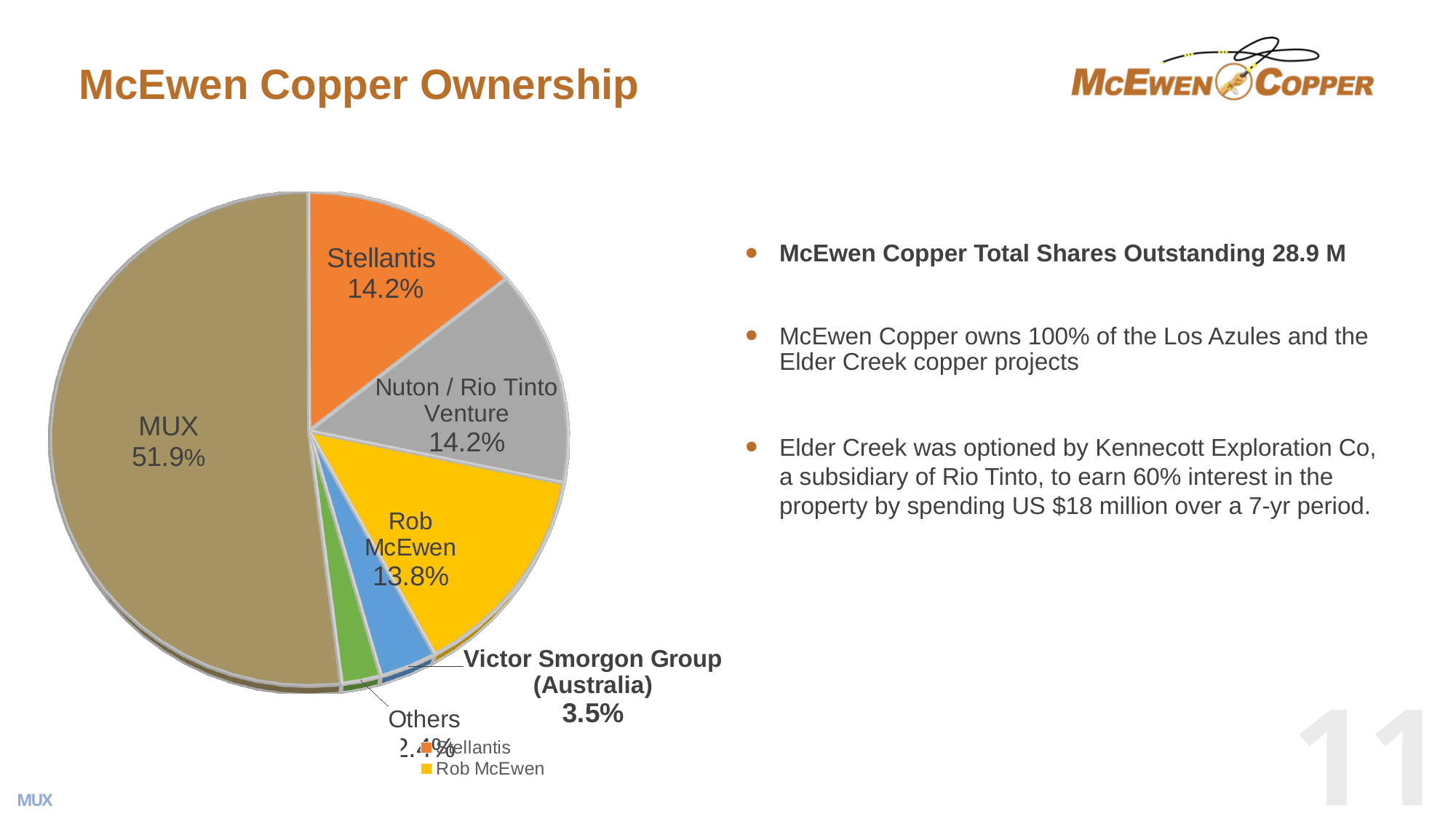
What is the difference between the MUX share and the Stellantis share? 37.7% Which is larger, the Rob McEwen slice or the Victor Smorgon Group (Australia) slice? Rob McEwen What share is shown for Victor Smorgon Group (Australia)? 3.5% What is the difference between the Stellantis share and the Rob McEwen share? 0.4% What is the value shown for Stellantis in the pie chart? 14.2% What kind of chart is shown on the slide? pie chart Which owner has the largest slice of the pie chart? MUX What is the title of the slide containing the pie chart? McEwen Copper Ownership What share of McEwen Copper does MUX own according to the pie chart? 51.9% What percentage is labelled for Rob McEwen in the pie chart? 13.8% What is the value shown for Nuton / Rio Tinto Venture? 14.2% How many slices does the pie chart have? 6